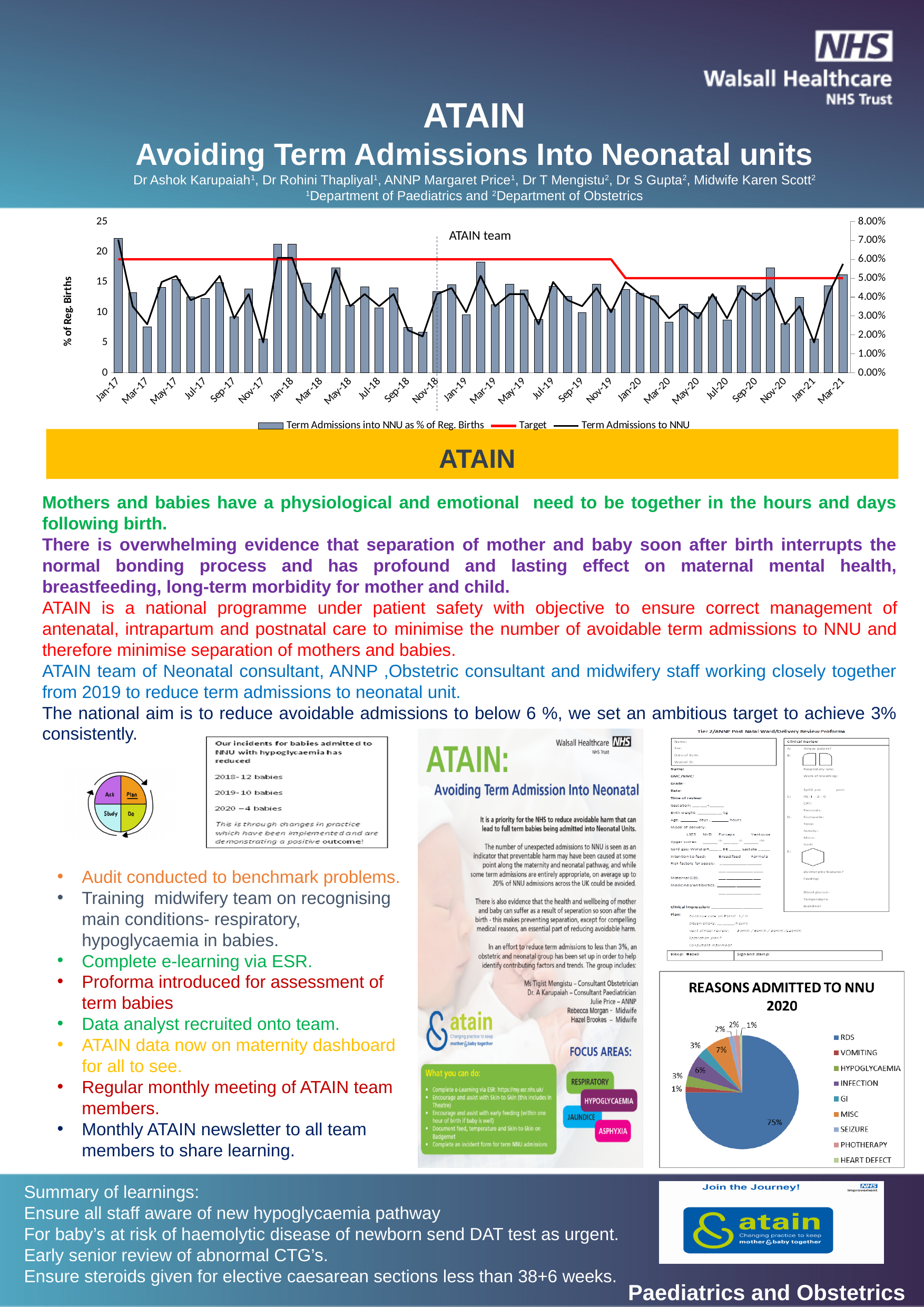
In the top chart showing term admissions, is the bar value for Mar-21 greater or less than 10? greater In the pie chart titled 'REASONS ADMITTED TO NNU 2020', is the share for RDS greater or less than 50%? greater What kind of chart is the 'REASONS ADMITTED TO NNU 2020' chart? pie chart What is the title of the pie chart at the bottom right of the slide? REASONS ADMITTED TO NNU 2020 In the pie chart titled 'REASONS ADMITTED TO NNU 2020', what share of admissions is attributed to RDS? 75% In the top chart showing term admissions, what is the title of the left vertical axis? % of Reg. Births In the pie chart titled 'REASONS ADMITTED TO NNU 2020', how many reasons are listed in the legend? 9 In the top chart showing term admissions, what are the three series named in the legend? Term Admissions into NNU as % of Reg. Births, Target, Term Admissions to NNU In the top chart showing term admissions, is the bar value for Jan-17 greater or less than 20? greater In the pie chart titled 'REASONS ADMITTED TO NNU 2020', which reason has the largest share? RDS What kind of chart is the large chart at the top of the slide showing term admissions? bar chart with line series In the top chart showing term admissions, how many series does the legend list? 3